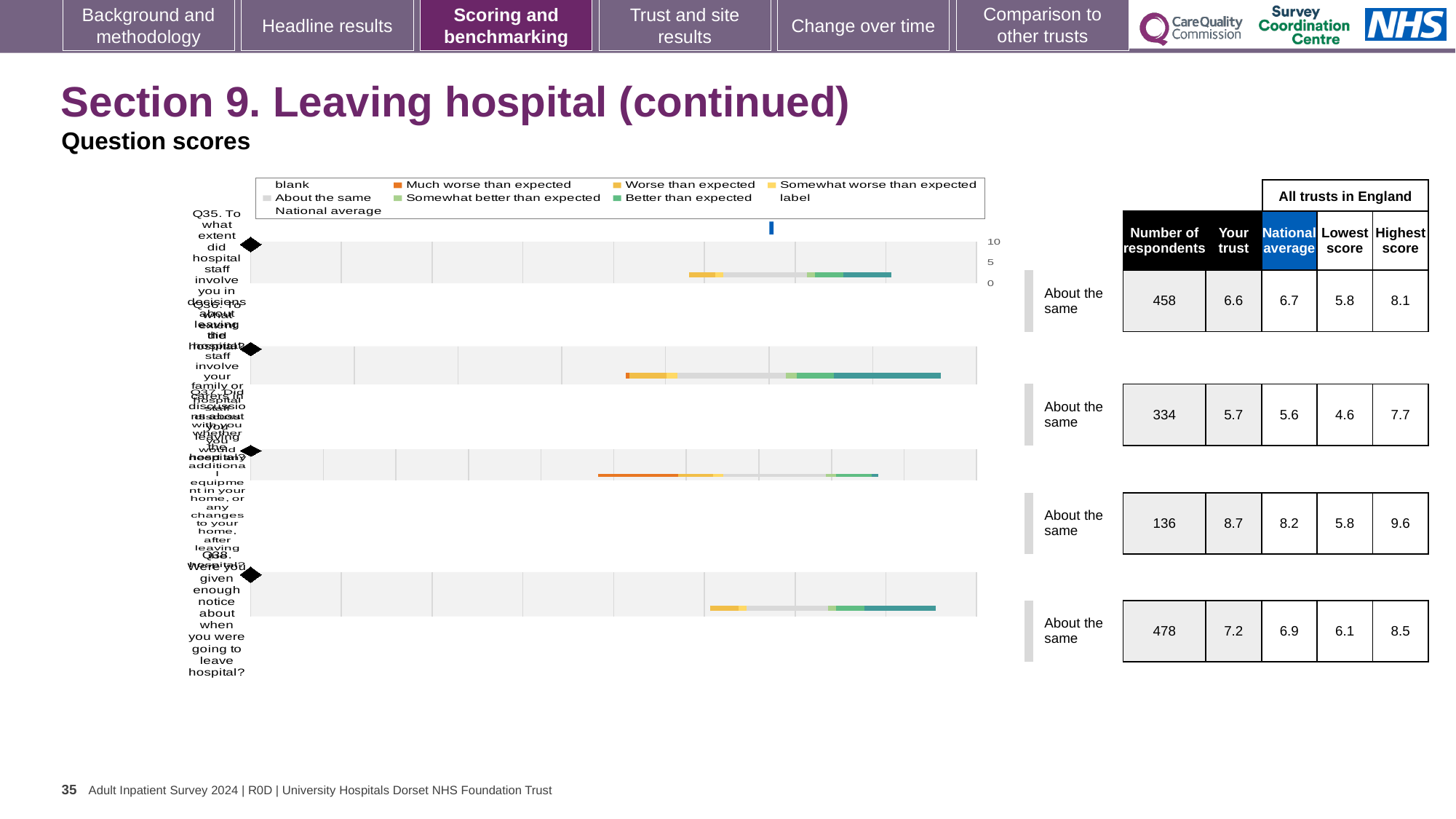
Which question has the highest 'Your trust' score? Q37 How many questions are plotted on the chart? 4 How many respondents are shown for Q35 (involving you in decisions about leaving hospital)? 458 What is the lowest score across all trusts in England for Q38? 6.1 What benchmark category is shown for Q36 (involving family or carers in discussions about leaving hospital)? About the same What kind of chart is used to show the question scores? Bar chart Which question has the lowest number of respondents? Q37 What is the difference between the 'Your trust' score and the national average for Q36? 0.1 What is the highest score across all trusts in England for Q37 (additional equipment or changes to your home)? 9.6 What is the difference between the highest and lowest scores across all trusts in England for Q37? 3.8 What is the 'Your trust' score for Q38 (enough notice about when you were going to leave hospital)? 7.2 For Q35, which is larger: the 'Your trust' score or the national average? National average